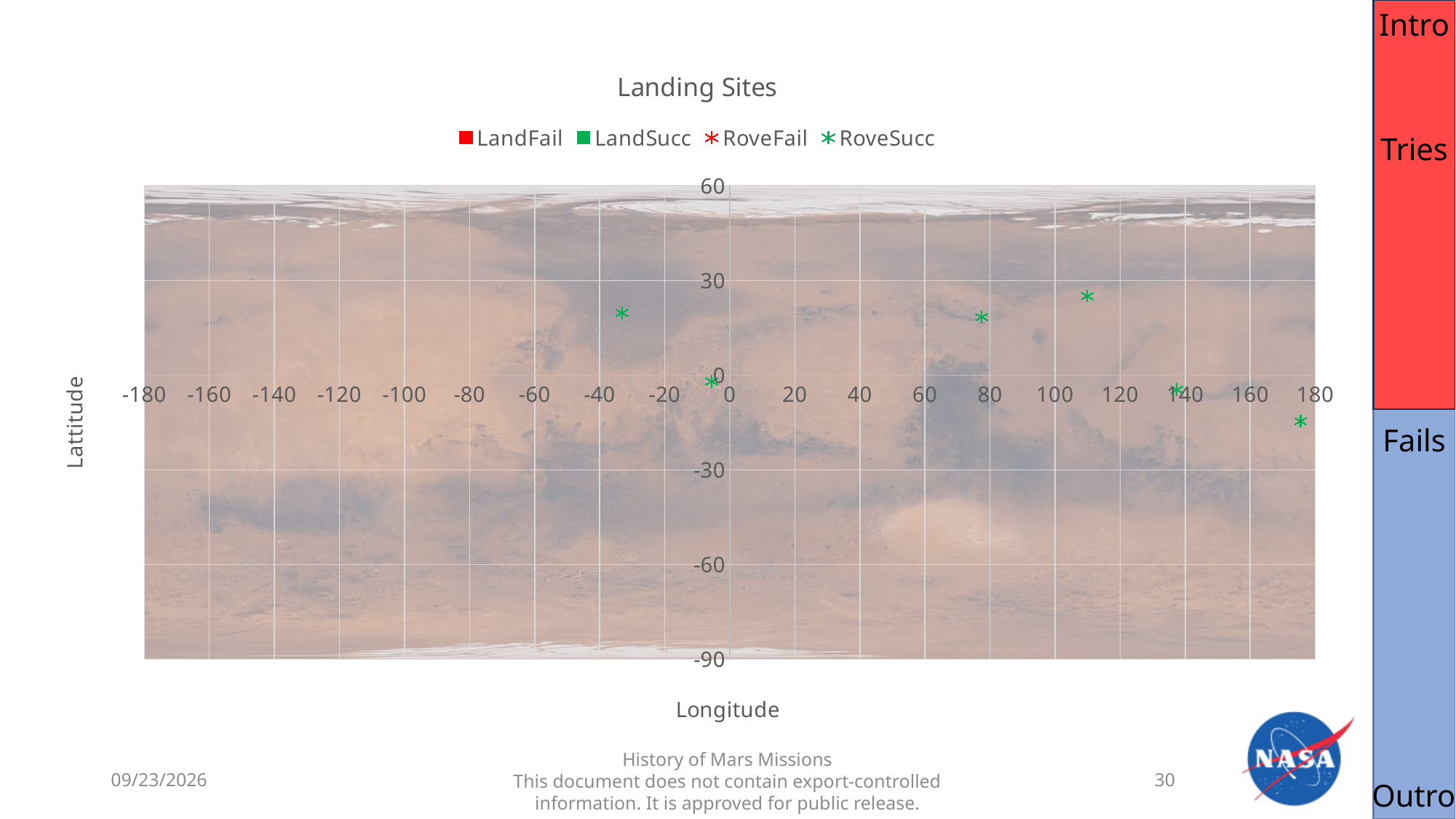
How many series does the chart legend list? 4 Is the latitude of the RoveSucc point plotted near longitude 80 greater or less than 30? less What label is shown on the vertical axis of the chart? Lattitude Is the latitude of the RoveSucc point plotted near longitude 0 greater or less than 30? less Is the latitude of the RoveSucc point plotted near longitude 110 greater or less than 0? greater What is the title of the chart? Landing Sites How many RoveSucc points are plotted on the chart? 6 What kind of chart is shown on the slide? scatter chart Which plotted RoveSucc point has the lowest latitude: the one near longitude 180 or the one near longitude -40? the one near longitude 180